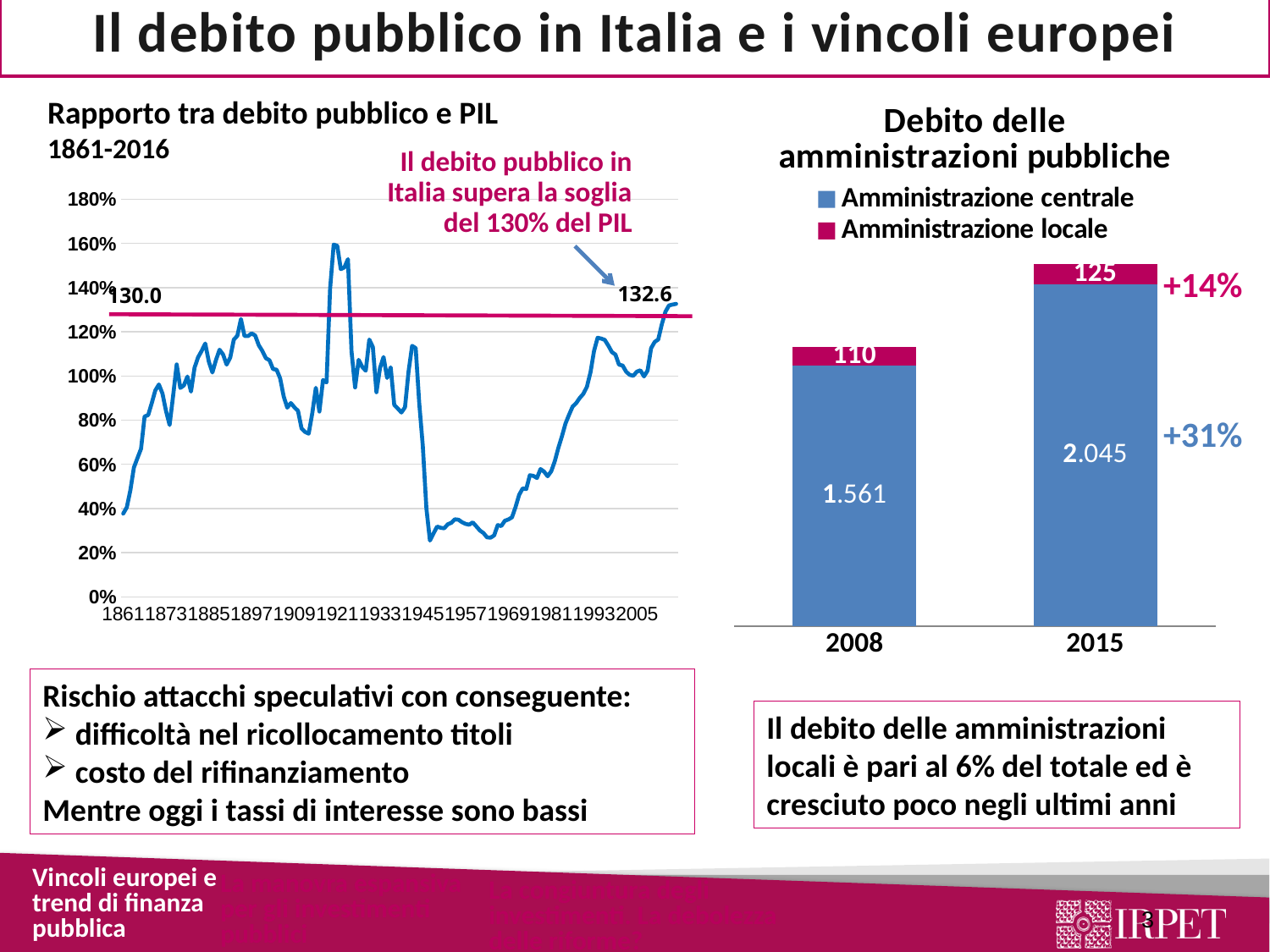
In the 'Debito delle amministrazioni pubbliche' chart, what is the value for Amministrazione locale in 2008? 110 How many series does the legend of the 'Debito delle amministrazioni pubbliche' chart list? 2 In the 'Debito delle amministrazioni pubbliche' chart, which year has the larger value for Amministrazione centrale, 2008 or 2015? 2015 How many years are shown on the x axis of the 'Debito delle amministrazioni pubbliche' chart? 2 What kind of chart is the 'Rapporto tra debito pubblico e PIL 1861-2016' chart on the left? line chart In the 'Debito delle amministrazioni pubbliche' chart, what is the value for Amministrazione centrale in 2008? 1.561 In the 'Rapporto tra debito pubblico e PIL 1861-2016' chart, is the value for 1861 greater or less than 60%? less In the 'Debito delle amministrazioni pubbliche' chart, what is the value for Amministrazione locale in 2015? 125 In the 'Debito delle amministrazioni pubbliche' chart, what is the difference between the Amministrazione locale values for 2015 and 2008? 15 In the 'Rapporto tra debito pubblico e PIL 1861-2016' chart, what value is labelled at the end of the line in 2016? 132.6 What kind of chart is the 'Debito delle amministrazioni pubbliche' chart on the right? bar chart In the 'Debito delle amministrazioni pubbliche' chart, what is the value for Amministrazione centrale in 2015? 2.045